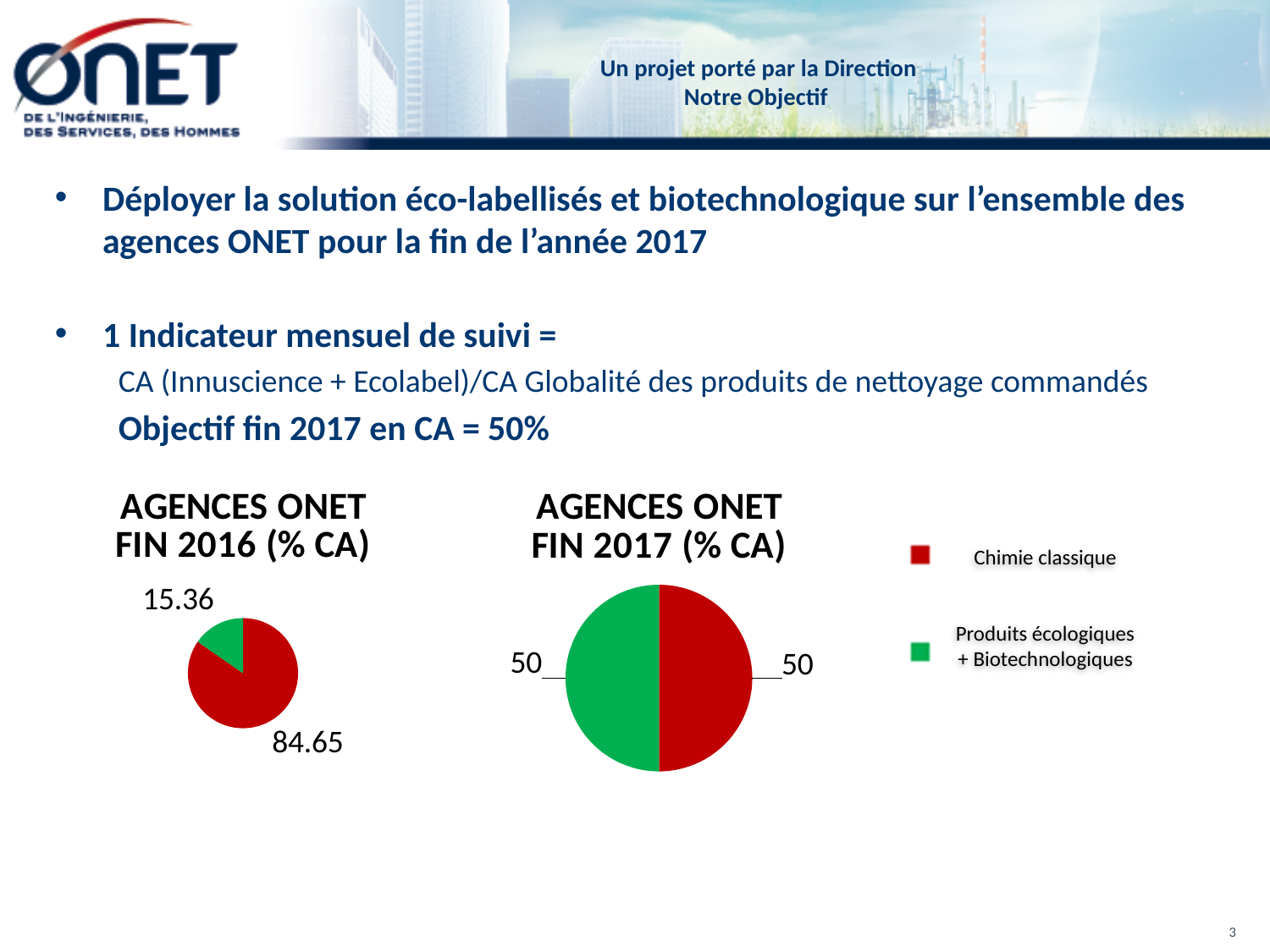
How many entries does the legend shared by the two pie charts list? 2 What kind of chart is 'AGENCES ONET FIN 2016 (% CA)'? Pie chart In the 'AGENCES ONET FIN 2016 (% CA)' pie chart, what is the value for Produits écologiques + Biotechnologiques? 15.36 In the 'AGENCES ONET FIN 2017 (% CA)' pie chart, what is the value for Chimie classique? 50 How many slices does the 'AGENCES ONET FIN 2017 (% CA)' pie chart have? 2 In the 'AGENCES ONET FIN 2016 (% CA)' pie chart, which category has the smallest slice? Produits écologiques + Biotechnologiques In the 'AGENCES ONET FIN 2016 (% CA)' pie chart, what is the difference between the Chimie classique value and the Produits écologiques + Biotechnologiques value? 69.29 In the 'AGENCES ONET FIN 2016 (% CA)' pie chart, which is larger: Chimie classique or Produits écologiques + Biotechnologiques? Chimie classique In the 'AGENCES ONET FIN 2016 (% CA)' pie chart, what is the value for Chimie classique? 84.65 In the 'AGENCES ONET FIN 2017 (% CA)' pie chart, what is the value for Produits écologiques + Biotechnologiques? 50 In the legend next to the pie charts, which colour represents Chimie classique? Red In the 'AGENCES ONET FIN 2016 (% CA)' pie chart, which category has the largest slice? Chimie classique